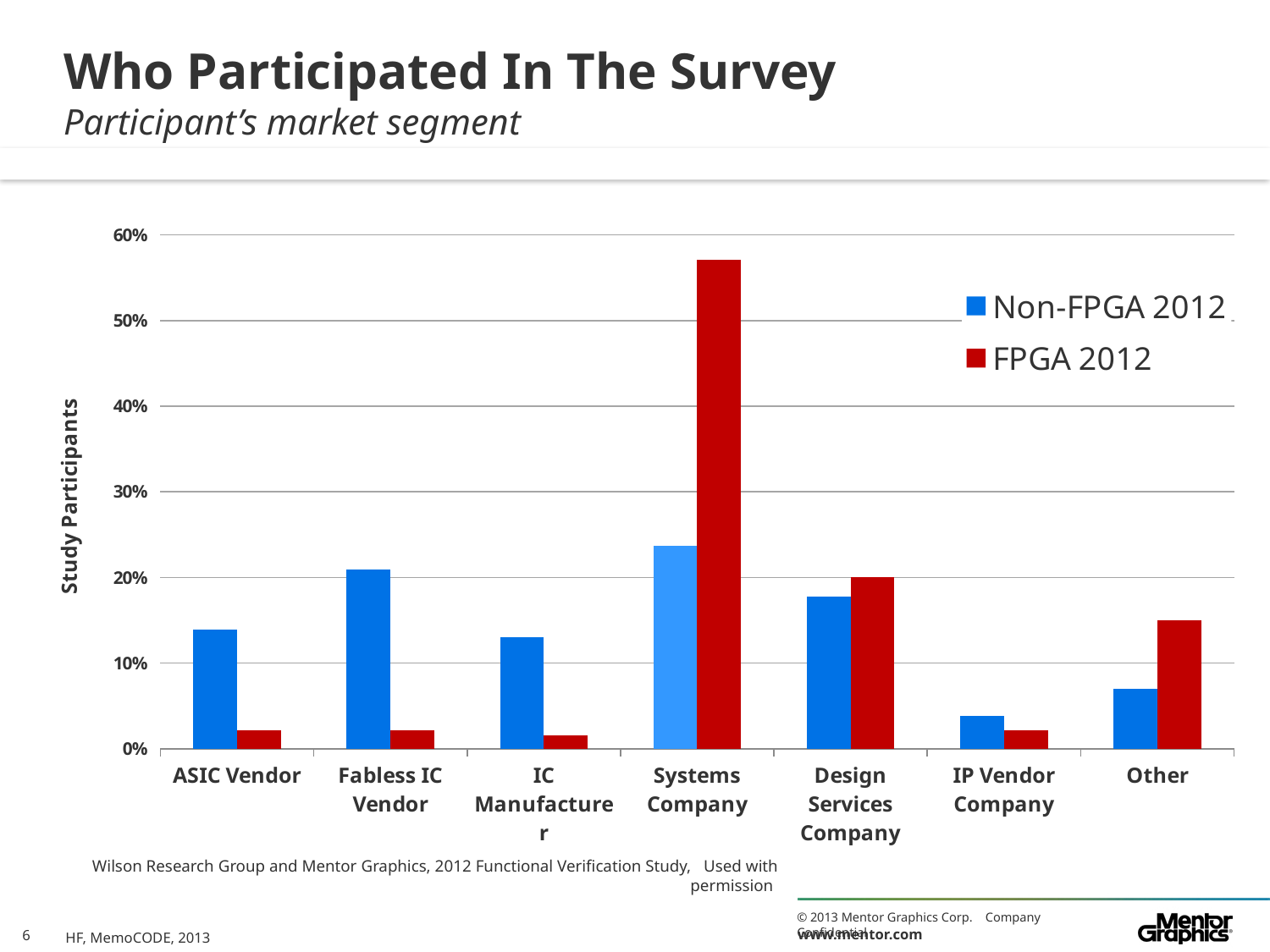
Is the FPGA 2012 value for ASIC Vendor greater or less than 10%? less Is the FPGA 2012 value for Systems Company greater or less than 50%? greater For Systems Company, which series has the larger value, Non-FPGA 2012 or FPGA 2012? FPGA 2012 How many market segment categories are shown on the x axis? 7 How many series does the legend list? 2 Which category has the highest value for the Non-FPGA 2012 series? Systems Company For Fabless IC Vendor, which series has the larger value, Non-FPGA 2012 or FPGA 2012? Non-FPGA 2012 Which category has the highest value for the FPGA 2012 series? Systems Company What kind of chart is shown on the slide? bar chart Which category has the lowest value for the Non-FPGA 2012 series? IP Vendor Company What is the title of the vertical axis? Study Participants Is the Non-FPGA 2012 value for ASIC Vendor greater or less than 10%? greater